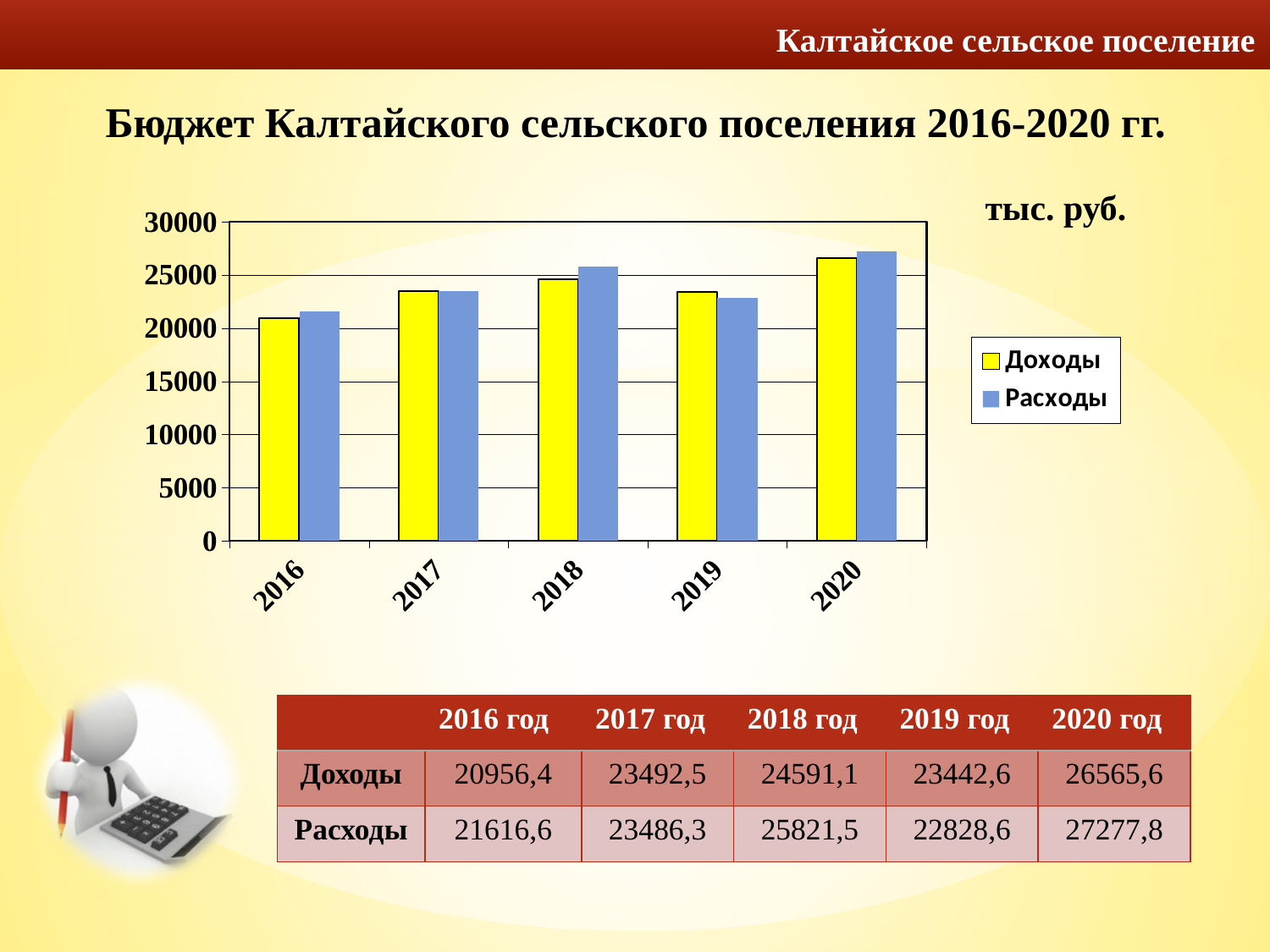
How many years are shown on the x axis of the chart? 5 What is the value of Расходы for 2020? 27277,8 How many series does the chart legend list? 2 What is the value of Расходы for 2018? 25821,5 What is the value of Доходы for 2016? 20956,4 What kind of chart is shown on the slide? bar chart In 2019, which is larger, Доходы or Расходы? Доходы In which year are Расходы lowest? 2016 Is the value of Расходы for 2020 greater or less than 25000? greater In which year are Доходы highest? 2020 What is the difference between Доходы and Расходы in 2019? 614 What is the difference between Расходы and Доходы in 2018? 1230,4